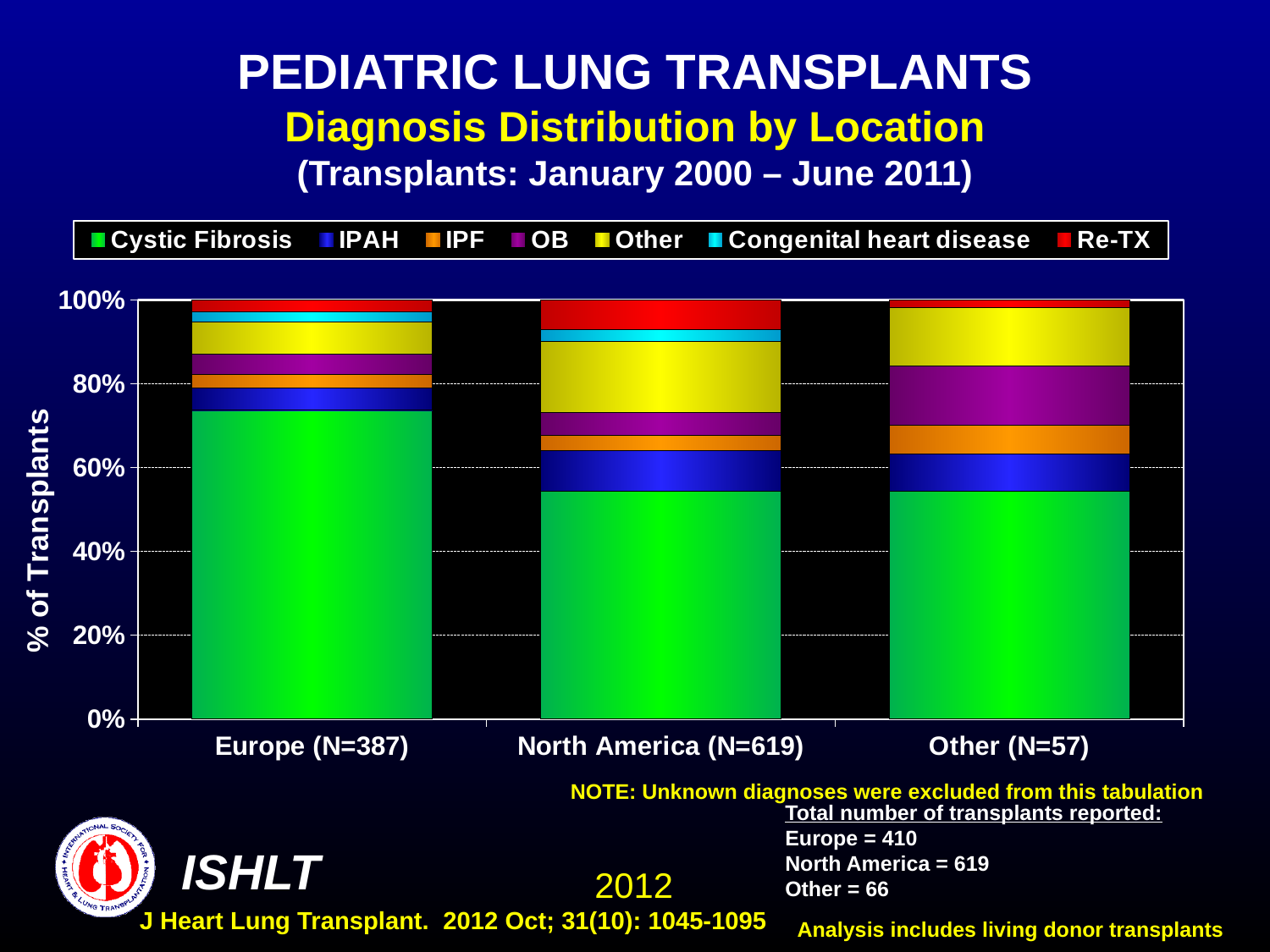
Which location has the largest OB share of transplants? Other (N=57) Is the Cystic Fibrosis share for Other (N=57) greater or less than 60%? less What kind of chart is shown on the slide? Stacked bar chart Which location has the largest Re-TX share of transplants? North America (N=619) Is the Cystic Fibrosis share for Europe (N=387) greater or less than 60%? greater How many location categories are plotted on the x axis? 3 How many diagnosis series does the legend list? 7 What is the label of the y axis? % of Transplants Is the Cystic Fibrosis share for North America (N=619) greater or less than 60%? less Which location has the largest Cystic Fibrosis share of transplants? Europe (N=387) Which is larger, the Cystic Fibrosis share for Europe or for North America? Europe What is the total height of each stacked bar on the y axis? 100%